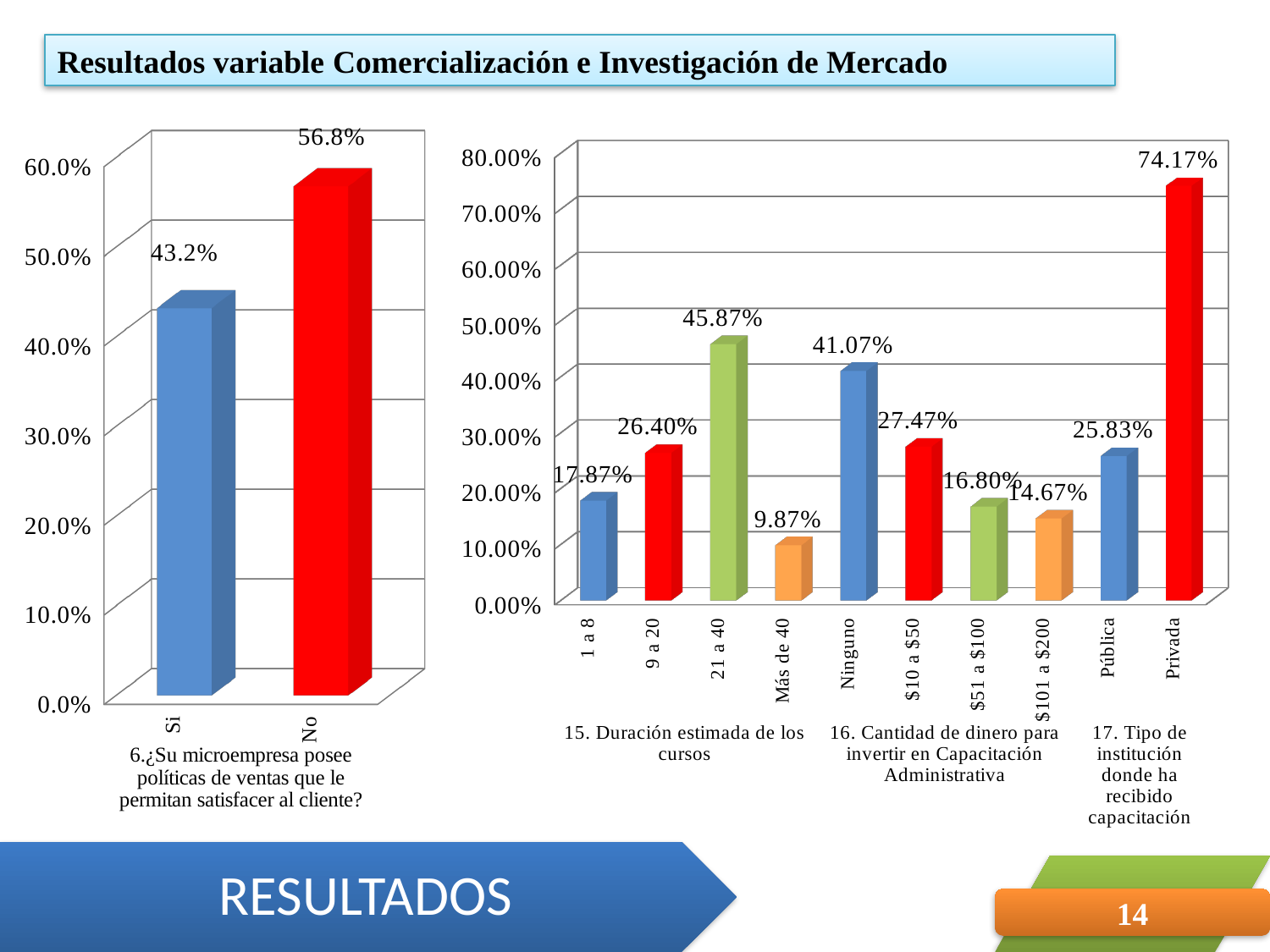
What kind of chart is the left chart? Bar chart In the left chart, what is the value for "Si"? 43.2% In the right chart, what is the value for "Privada"? 74.17% In the right chart, which category has the lowest value? Más de 40 How many bars are plotted in the right chart? 10 In the right chart, which is larger, the value for "Ninguno" or the value for "$10 a $50"? Ninguno In the right chart, what is the value for "21 a 40"? 45.87% In the right chart, which category has the highest value? Privada In the left chart, what is the difference between the values for "No" and "Si"? 13.6% In the right chart, what is the difference between the values for "Privada" and "Pública"? 48.34% In the left chart, which category has the higher value, "Si" or "No"? No In the left chart, what is the value for "No"? 56.8%